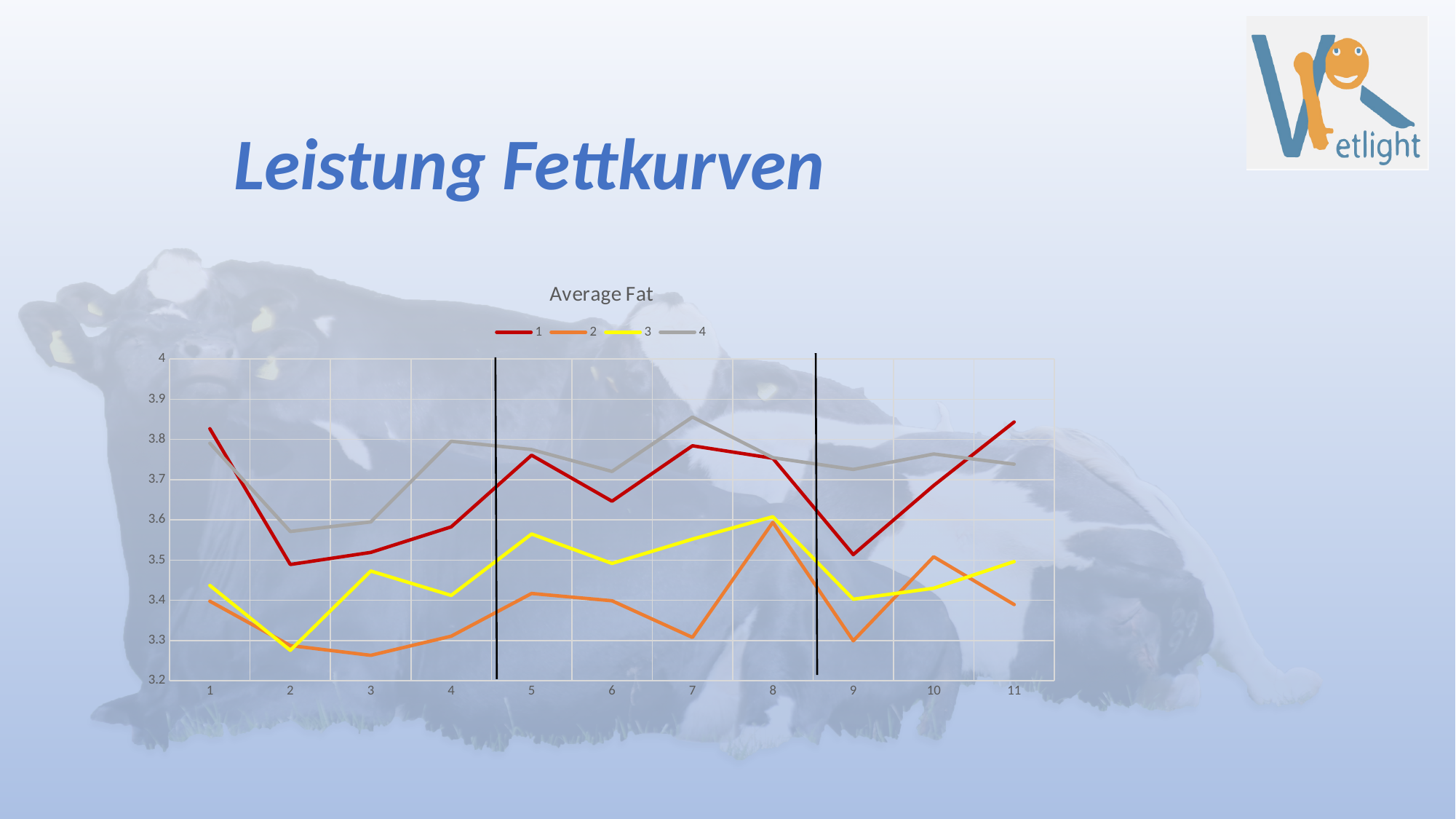
How many series does the legend of the Average Fat chart list? 4 Is the value for series 3 at point 5 greater or less than 3.5? greater What is the title of the chart? Average Fat How many points are plotted along the x axis for each series in the Average Fat chart? 11 Is the value for series 2 at point 3 greater or less than 3.3? less At point 7, which series has the higher value, series 1 or series 4? series 4 Which series has the lowest value at point 3? series 2 What kind of chart is shown on the slide? line chart What colour is the line for series 1 in the Average Fat chart? red Does the value for series 1 rise or fall from point 9 to point 11? rise Is the value for series 4 at point 7 greater or less than 3.8? greater